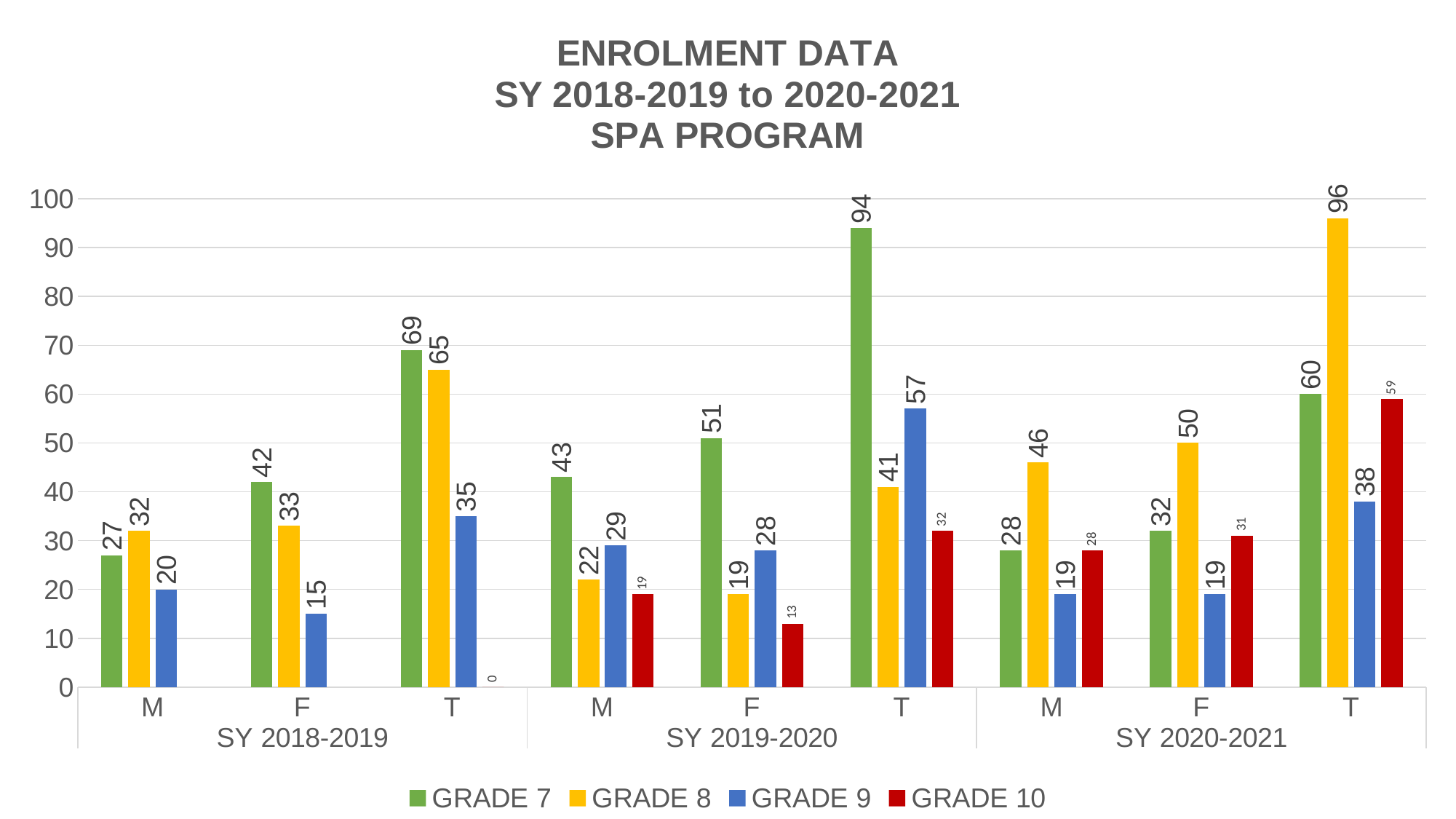
What is the GRADE 10 value for M in SY 2019-2020? 19 What is the GRADE 8 value for T in SY 2020-2021? 96 Which is larger for M in SY 2020-2021: GRADE 7 or GRADE 8? GRADE 8 What is the GRADE 7 value for T in SY 2019-2020? 94 Which series has the lowest value for F in SY 2020-2021? GRADE 9 What is the GRADE 9 value for F in SY 2018-2019? 15 What colour represents GRADE 10 in the chart? Red What kind of chart is shown on the slide? Bar chart How many series does the legend list? 4 What is the difference between the GRADE 7 and GRADE 8 values for T in SY 2019-2020? 53 Which series has the highest value for T in SY 2018-2019? GRADE 7 How do the GRADE 8 values for T change from SY 2018-2019 to SY 2020-2021? They fall then rise (65, 41, 96)